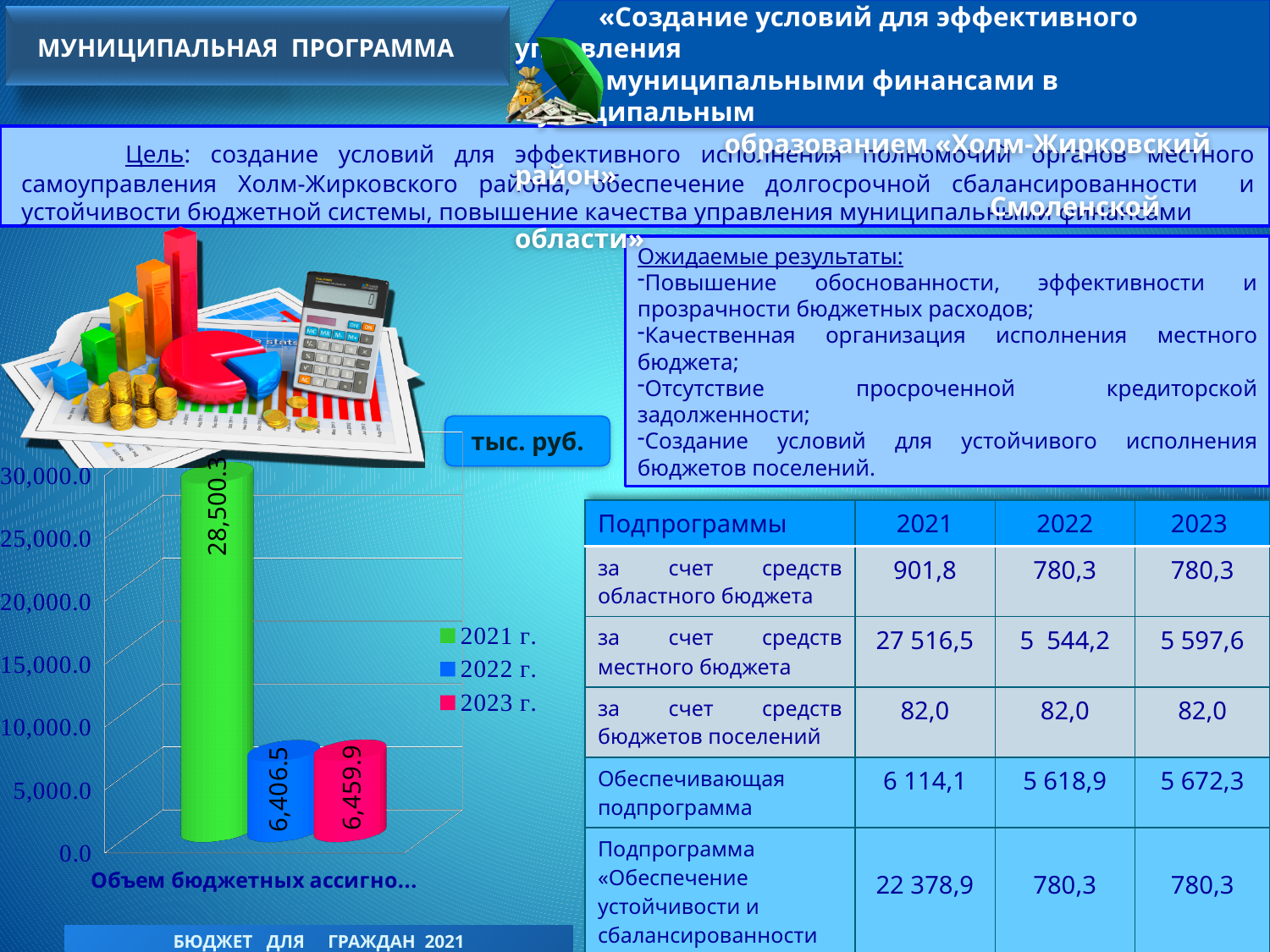
What kind of chart is shown on the slide? bar chart What is the difference between the 2021 г. and 2022 г. values in the chart? 22,093.8 What is the difference between the 2023 г. and 2022 г. values in the chart? 53.4 Which year has the highest bar in the chart? 2021 г. Which year has the lowest bar in the chart? 2022 г. What is the value of the 2021 г. bar in the chart? 28,500.3 What is the value of the 2022 г. bar in the chart? 6,406.5 How many series does the chart legend list? 3 Which is larger in the chart, the 2022 г. value or the 2023 г. value? 2023 г. What is the value of the 2023 г. bar in the chart? 6,459.9 Is the value for 2021 г. in the chart greater or less than 25,000.0? greater What unit is shown in the label above the chart? тыс. руб.